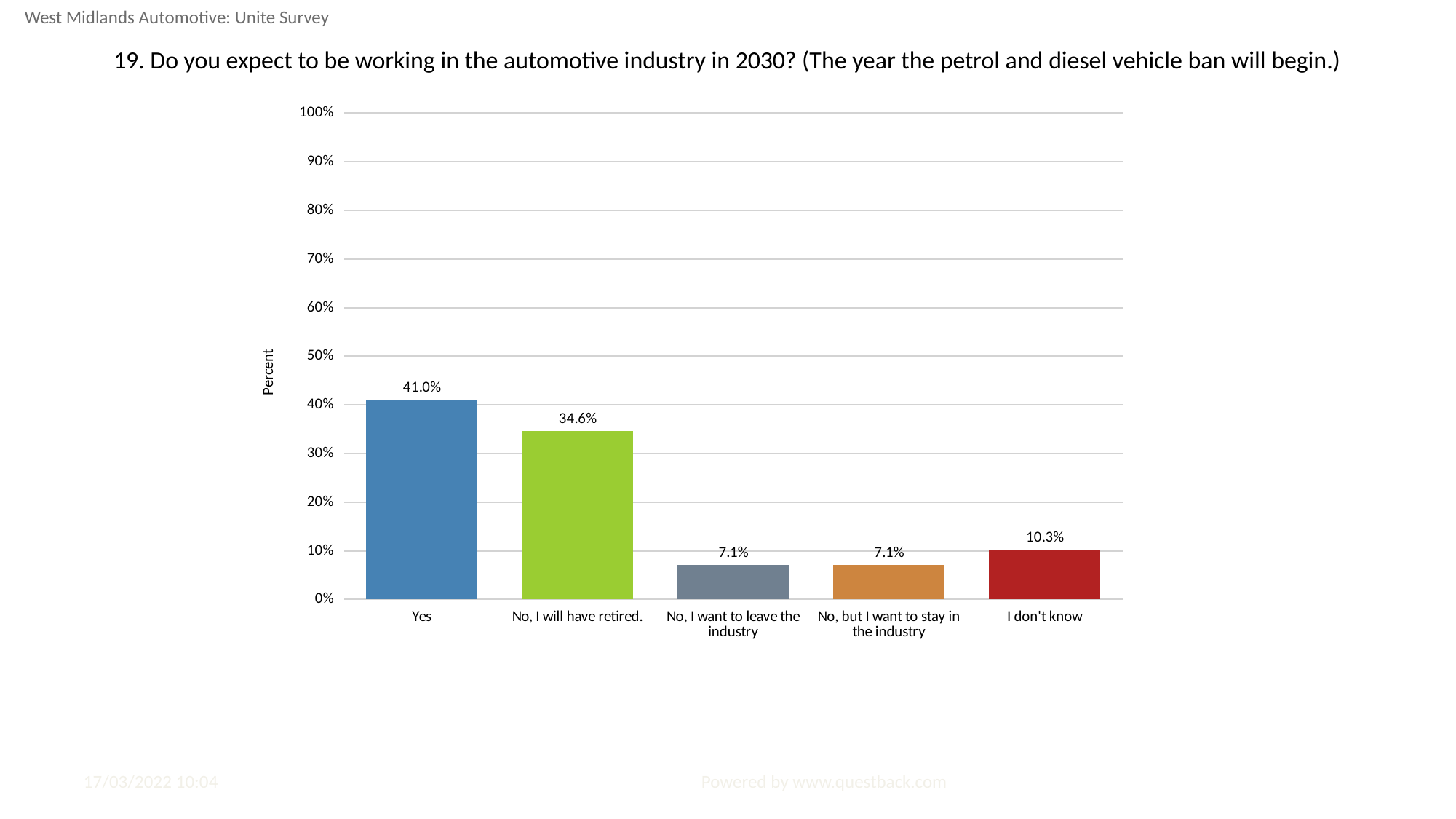
How many response categories are shown on the x axis? 5 What percentage of respondents answered "No, I will have retired."? 34.6% What percentage of respondents answered "Yes"? 41.0% What percentage of respondents answered "I don't know"? 10.3% Is the value for "No, I will have retired." greater or less than 30%? greater What is the difference in percentage points between "Yes" and "No, I will have retired."? 6.4 percentage points What kind of chart is shown on the slide? Bar chart What is the difference in percentage points between "I don't know" and "No, but I want to stay in the industry"? 3.2 percentage points Which response category has the highest percentage? Yes What is the label of the y axis? Percent Which is larger: the value for "I don't know" or the value for "No, I want to leave the industry"? I don't know What percentage of respondents answered "No, I want to leave the industry"? 7.1%